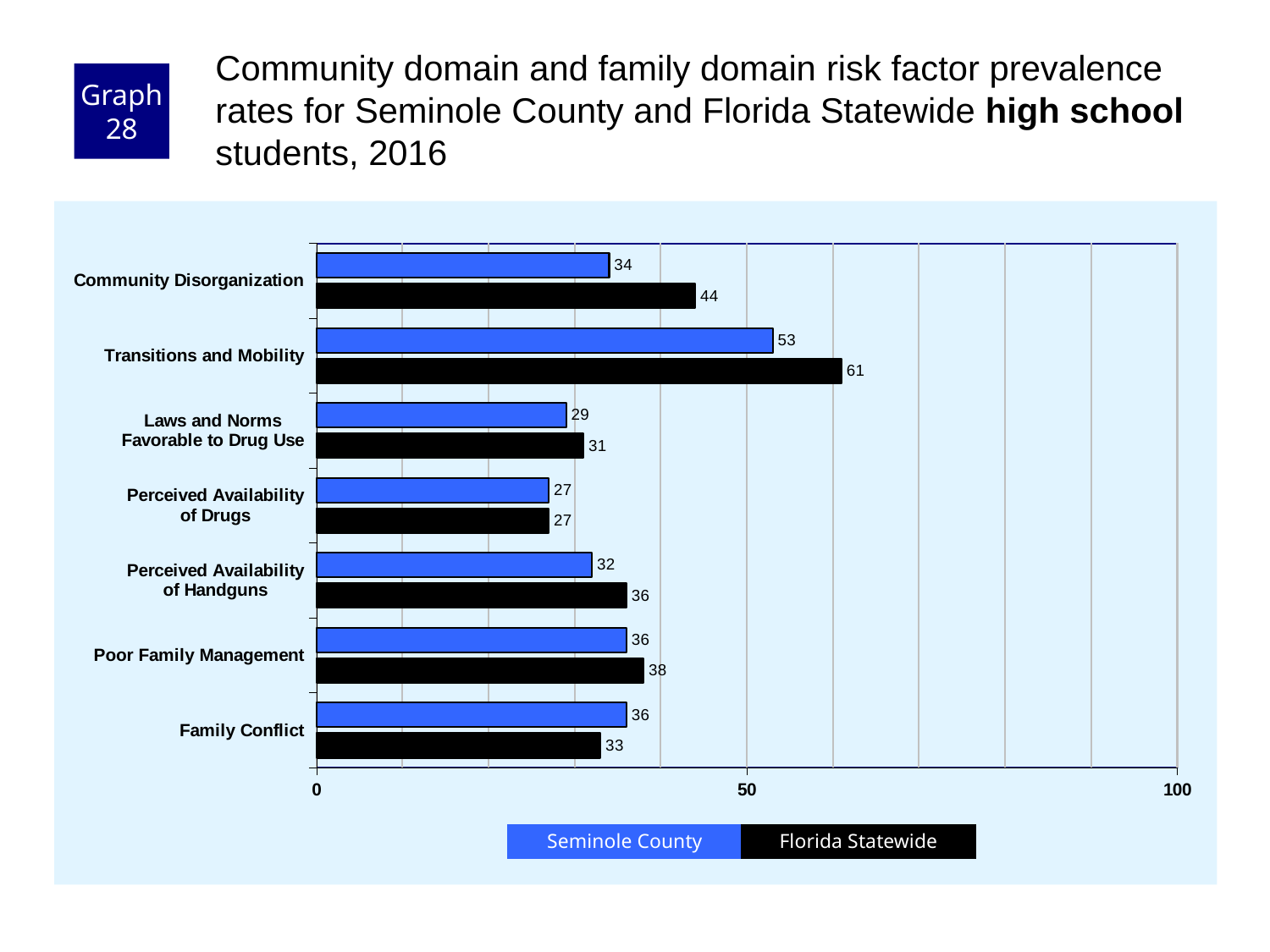
What kind of chart is shown on the slide? Bar chart Which risk factor has the highest Florida Statewide value? Transitions and Mobility Which risk factor has the lowest Seminole County value? Perceived Availability of Drugs What is the difference between the Florida Statewide and Seminole County values for Community Disorganization? 10 What is the difference between the Florida Statewide and Seminole County values for Transitions and Mobility? 8 How many risk factors are shown on the chart? 7 What is the Seminole County value for Transitions and Mobility? 53 Is the Florida Statewide value for Transitions and Mobility greater or less than 50? greater How many series does the legend list? 2 For Family Conflict, which is larger: the Seminole County value or the Florida Statewide value? Seminole County What is the Florida Statewide value for Community Disorganization? 44 What is the Florida Statewide value for Family Conflict? 33